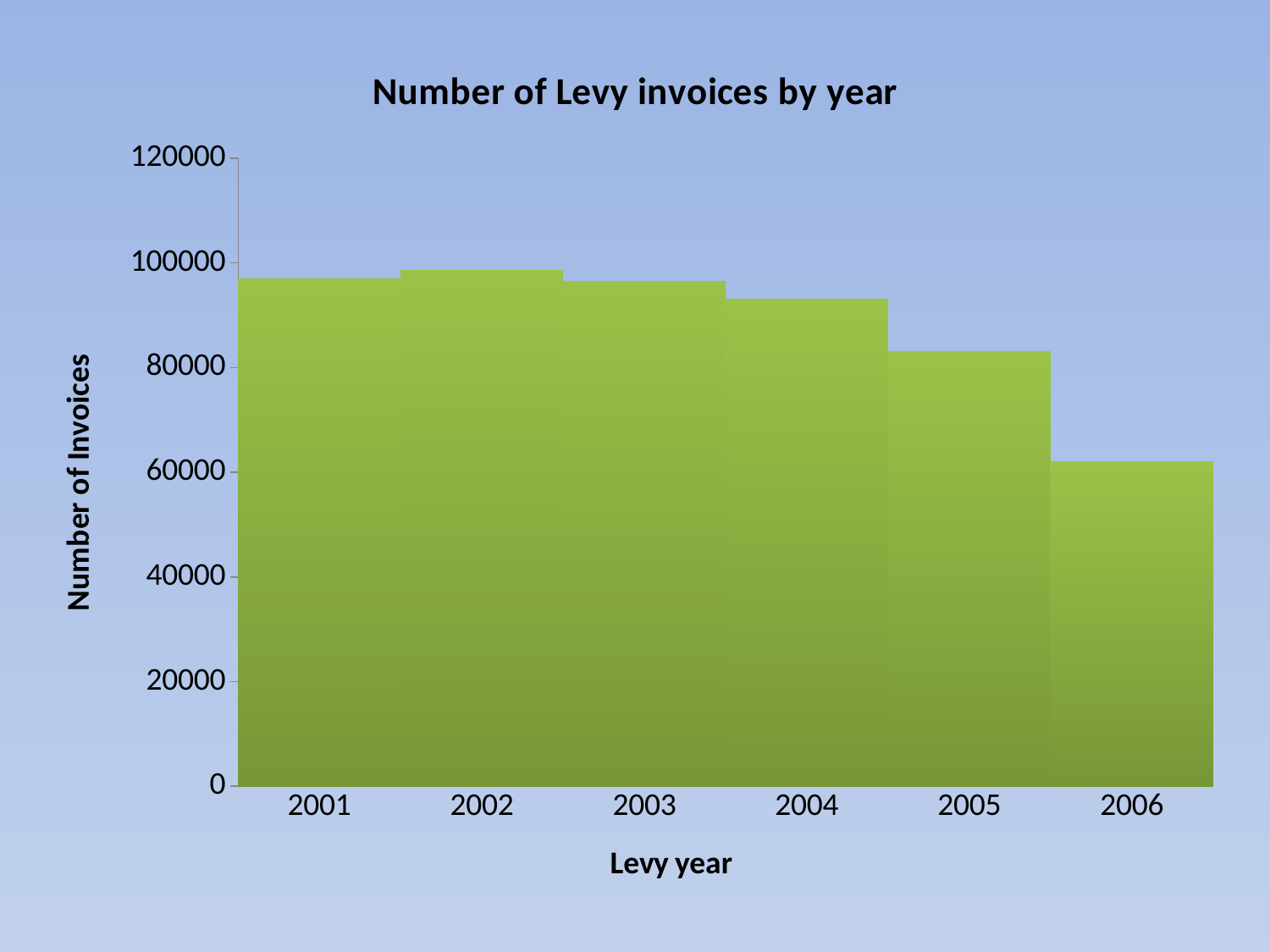
Is the value for 2005 greater or less than 100000? less Is the value for 2006 greater or less than 80000? less Do the values rise or fall from 2002 to 2006? fall Which year has the lowest number of Levy invoices? 2006 Is the value for 2001 greater or less than 100000? less What kind of chart is shown on the slide? bar chart Which year has more Levy invoices, 2005 or 2006? 2005 Which year has more Levy invoices, 2004 or 2005? 2004 What is the title of the chart? Number of Levy invoices by year What is the label of the vertical axis? Number of Invoices How many years are plotted on the x axis? 6